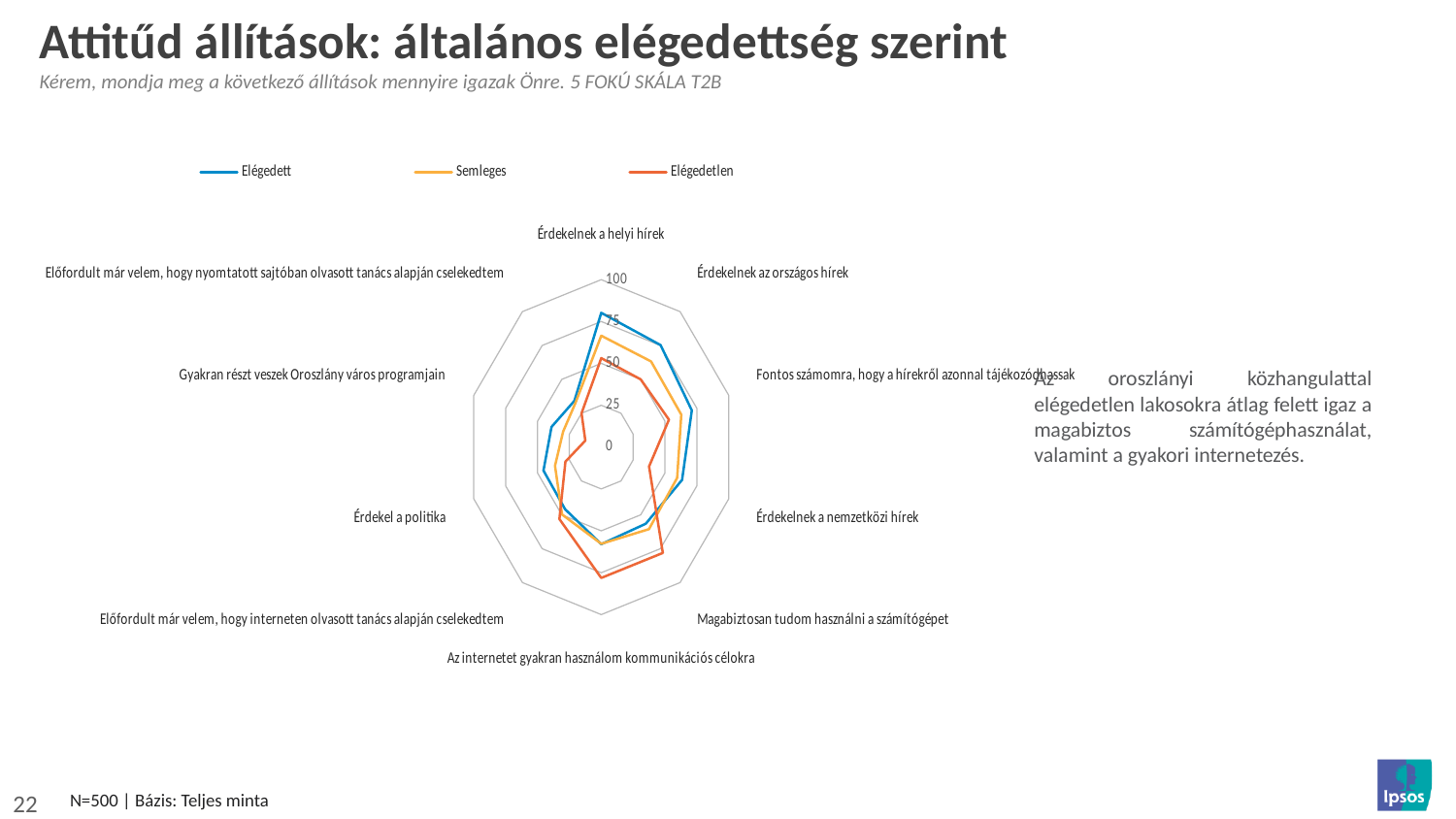
What kind of chart is shown on the slide? Radar chart Which series is drawn in blue? Elégedett What is the highest value shown on the radar chart's axis scale? 100 For "Az internetet gyakran használom kommunikációs célokra", which is larger: Elégedett or Elégedetlen? Elégedetlen Is the value for Elégedetlen on "Gyakran részt veszek Oroszlány város programjain" greater or less than 50? less How many series does the legend list? 3 Is the value for Elégedett on "Érdekelnek a helyi hírek" greater or less than 50? greater For "Érdekelnek az országos hírek", which is larger: Elégedett or Elégedetlen? Elégedett Is the value for Elégedetlen on "Érdekel a politika" greater or less than 50? less Which series has the highest value for "Magabiztosan tudom használni a számítógépet"? Elégedetlen How many statements (axes) are plotted on the radar chart? 10 Which series has the highest value for "Érdekelnek a helyi hírek"? Elégedett